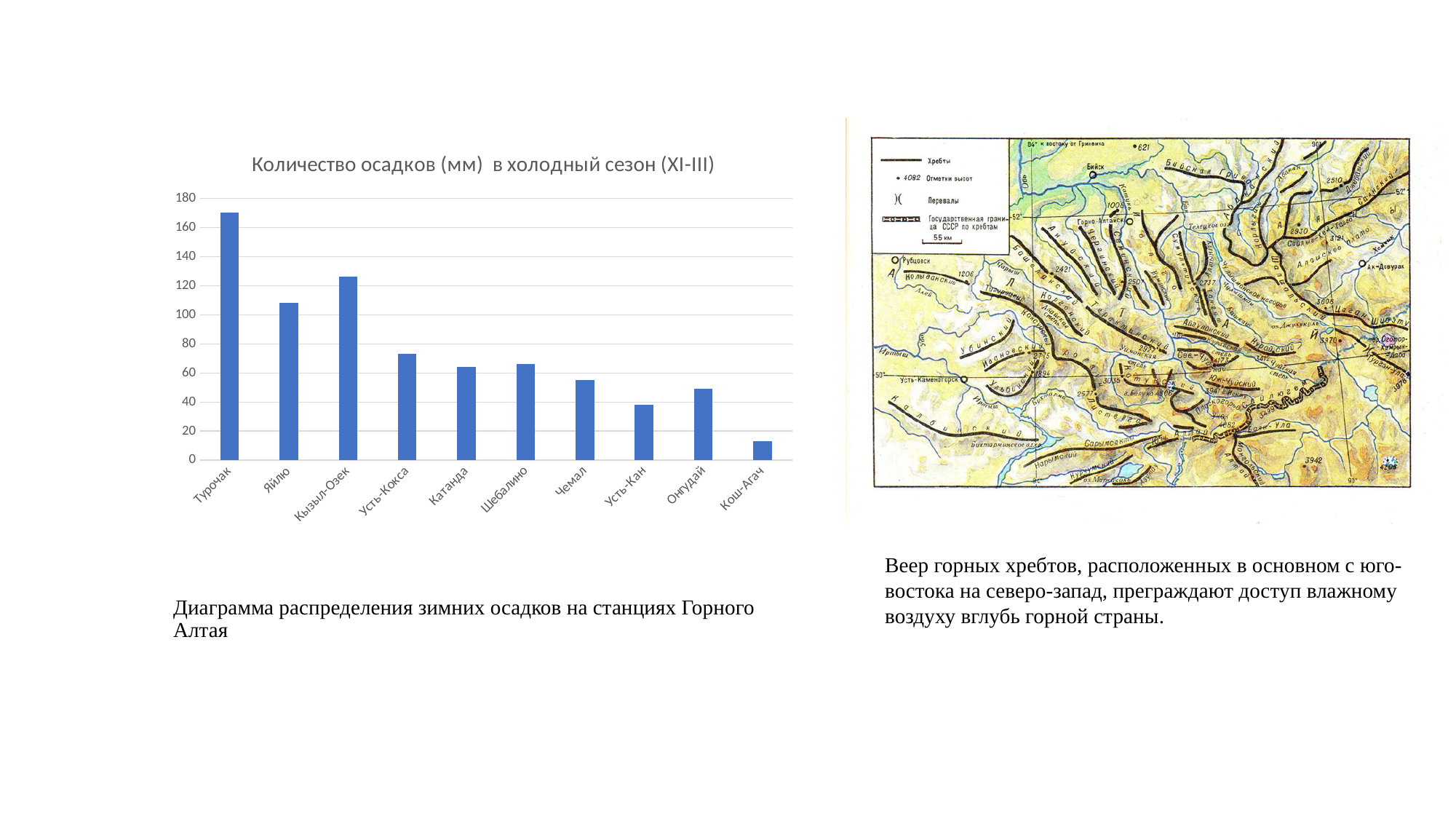
Which station has the lowest precipitation value on the chart? Кош-Агач Is the value for Усть-Кокса greater or less than 80? less Which has a larger value, Яйлю or Кызыл-Озек? Кызыл-Озек Is the value for Кош-Агач greater or less than 20? less Is the value for Кызыл-Озек greater or less than 120? greater Which station has the highest precipitation value on the chart? Турочак What kind of chart is shown on the slide? bar chart How many stations are shown on the chart? 10 What is the title of the chart? Количество осадков (мм) в холодный сезон (XI-III) Which has a larger value, Чемал or Онгудай? Чемал